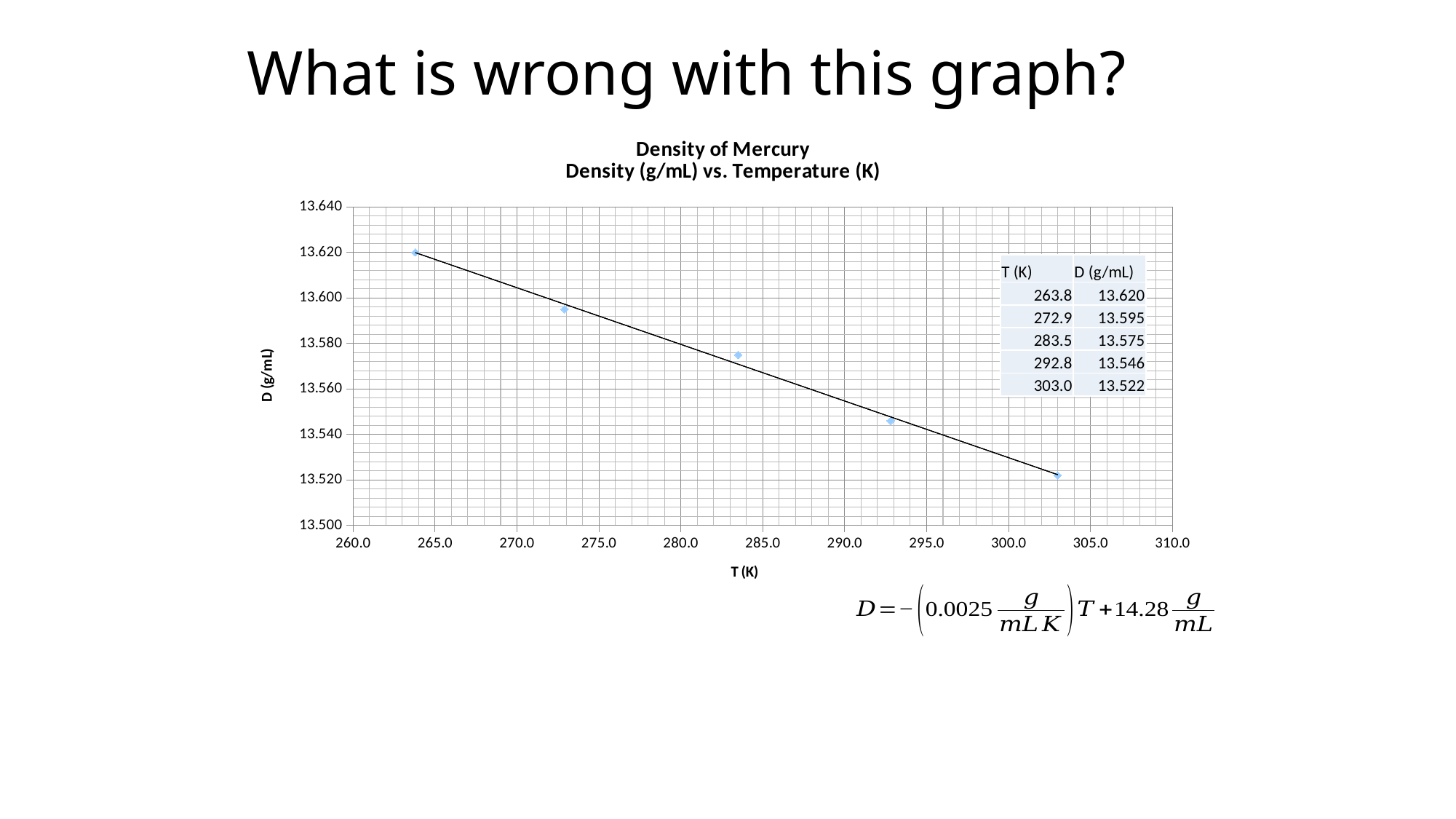
What is the density D (g/mL) at a temperature of 263.8 K? 13.620 What is the difference in density between 263.8 K and 303.0 K? 0.098 g/mL What kind of chart is shown on the slide? Scatter chart What is the density D (g/mL) at a temperature of 303.0 K? 13.522 What is the density D (g/mL) at a temperature of 283.5 K? 13.575 Which has the larger density, the point at 272.9 K or the point at 292.8 K? 272.9 K What is the label of the x axis of the chart? T (K) Does the density rise or fall as temperature increases along the x axis? Fall How many data points are plotted on the chart? 5 Is the density at 292.8 K greater or less than 13.560? less At which temperature is the density lowest? 303.0 K At which temperature is the density highest? 263.8 K